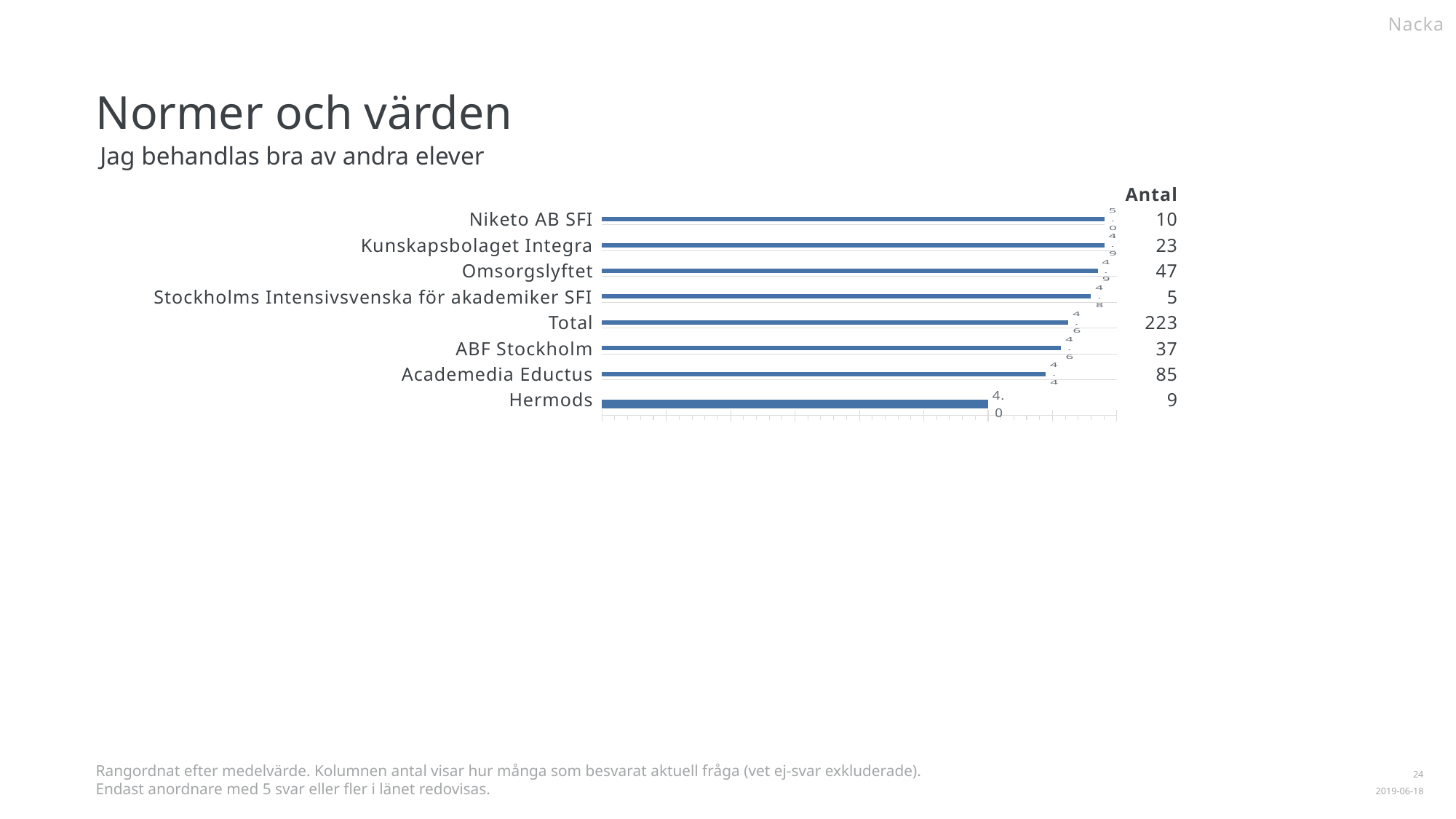
Which category has the longest bar in the chart? Niketo AB SFI What is the value shown for Hermods? 4.0 What is the Antal shown for Academedia Eductus? 85 Which has a larger value, Omsorgslyftet or Academedia Eductus? Omsorgslyftet What is the subtitle (question text) shown above the chart? Jag behandlas bra av andra elever What kind of chart is shown on the slide? bar chart Which category has the shortest bar in the chart? Hermods Which has a larger value, Niketo AB SFI or Hermods? Niketo AB SFI What is the Antal (number of respondents) shown for Total? 223 How many categories (bars) does the chart show? 8 What is the value shown for Niketo AB SFI? 5.0 What is the difference between the values for Niketo AB SFI and Hermods? 1.0